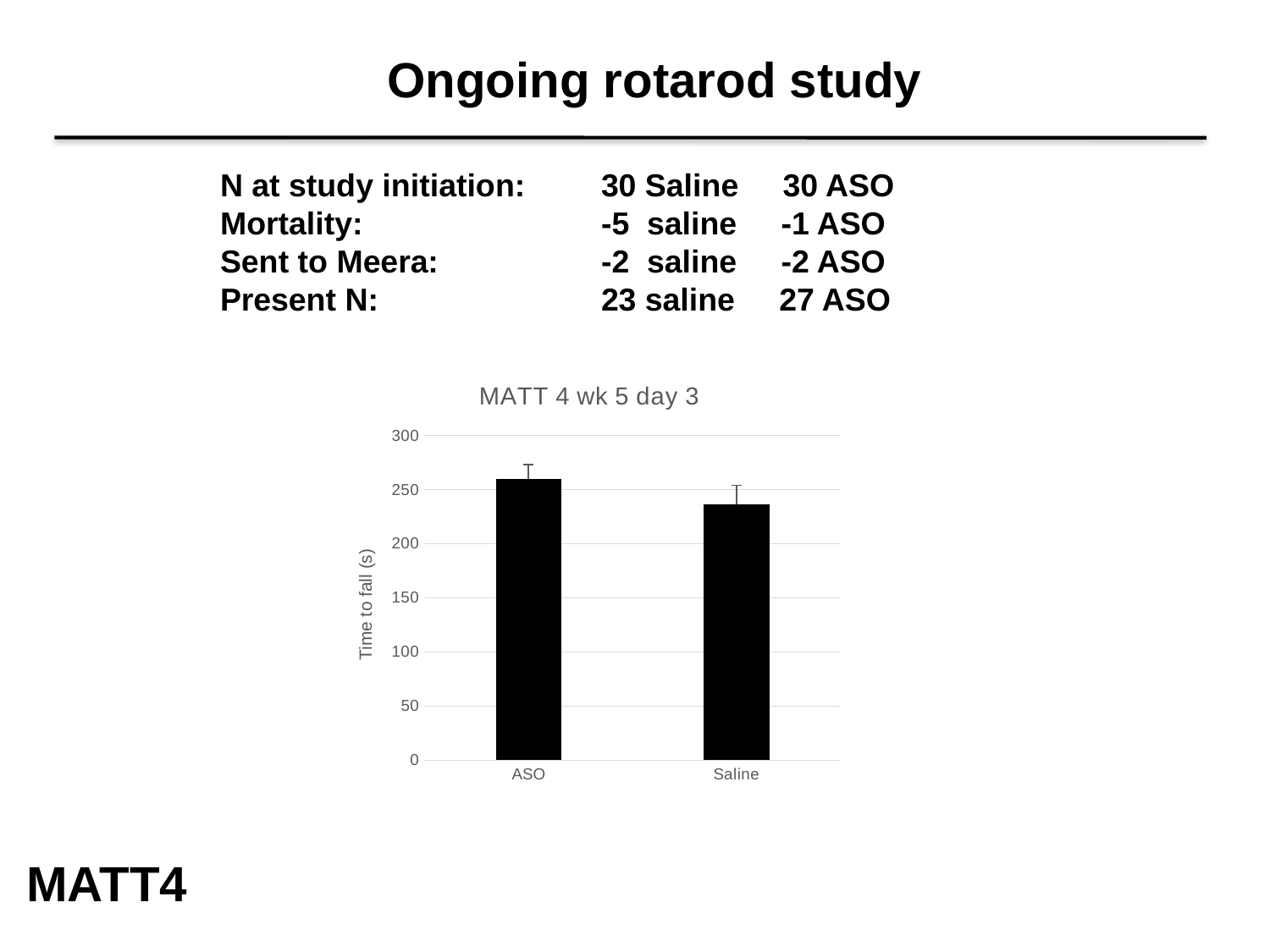
Which has a larger time to fall, ASO or Saline? ASO Do the values rise or fall going from ASO to Saline along the x axis? fall How many categories are plotted in the chart? 2 Which category has the highest time to fall? ASO What is the label of the y axis? Time to fall (s) Is the value for ASO greater or less than 200? greater Which category has the lowest time to fall? Saline Is the value for Saline greater or less than 200? greater What kind of chart is shown on the slide? bar chart What is the title of the chart? MATT 4 wk 5 day 3 Is the value for Saline greater or less than 250? less